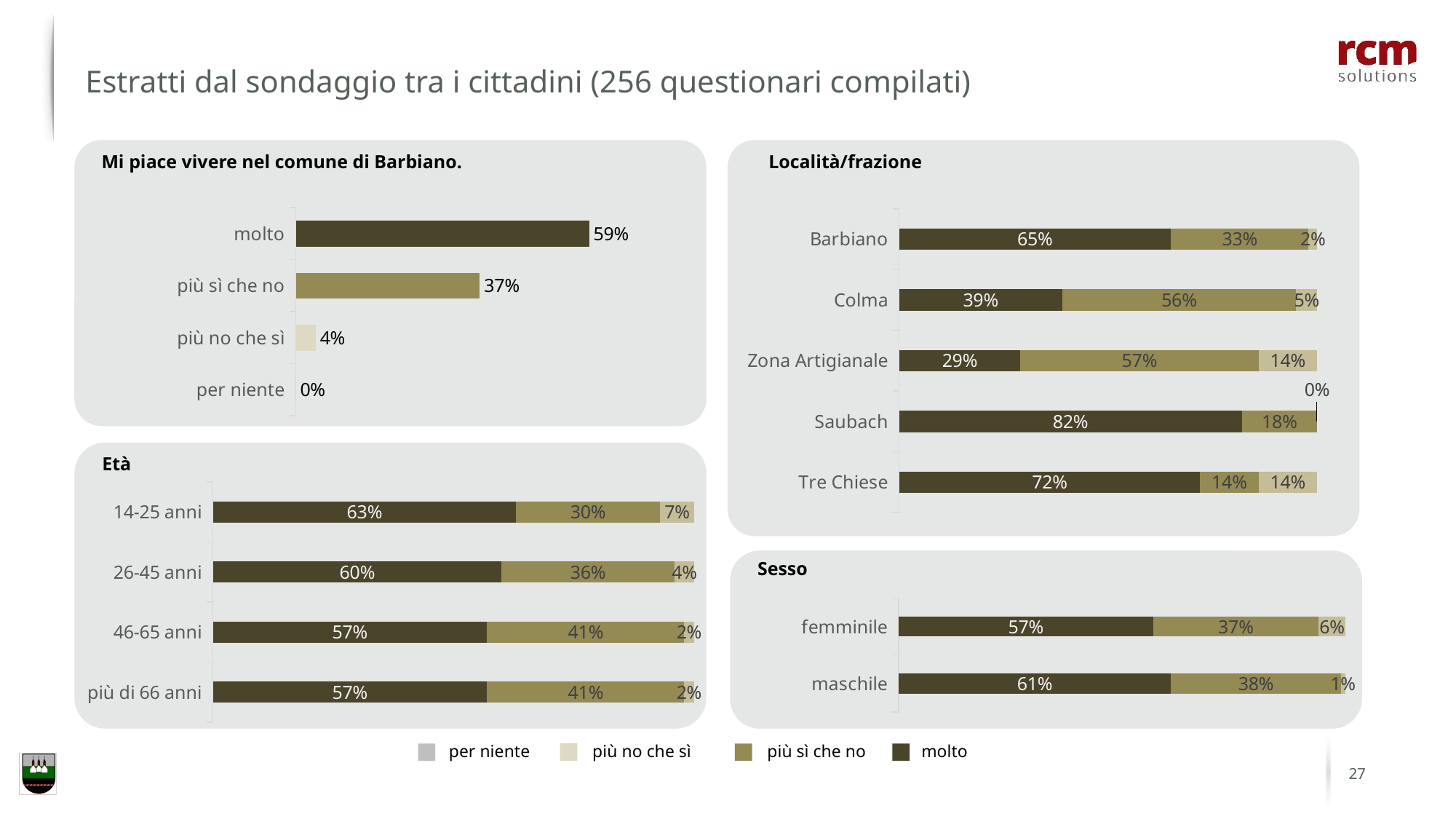
In the "Sesso" chart, what is the "più no che sì" value for "maschile"? 1% How many series does the shared legend at the bottom of the slide list? 4 In the chart titled "Mi piace vivere nel comune di Barbiano.", what is the value for "molto"? 59% In the chart titled "Mi piace vivere nel comune di Barbiano.", which category has the lowest value? per niente In the chart titled "Mi piace vivere nel comune di Barbiano.", what is the difference between the values for "molto" and "più sì che no"? 22% In the "Sesso" chart, what is the difference between the "molto" values for "maschile" and "femminile"? 4% In the "Età" chart, what is the "molto" value for "14-25 anni"? 63% In the "Località/frazione" chart, which locality has the highest "molto" value? Saubach In the "Località/frazione" chart, what is the "più sì che no" value for "Zona Artigianale"? 57% In the "Età" chart, how many age categories are shown? 4 What kind of chart is the one titled "Mi piace vivere nel comune di Barbiano."? bar chart In the "Località/frazione" chart, is the "molto" value for "Barbiano" or for "Colma" larger? Barbiano